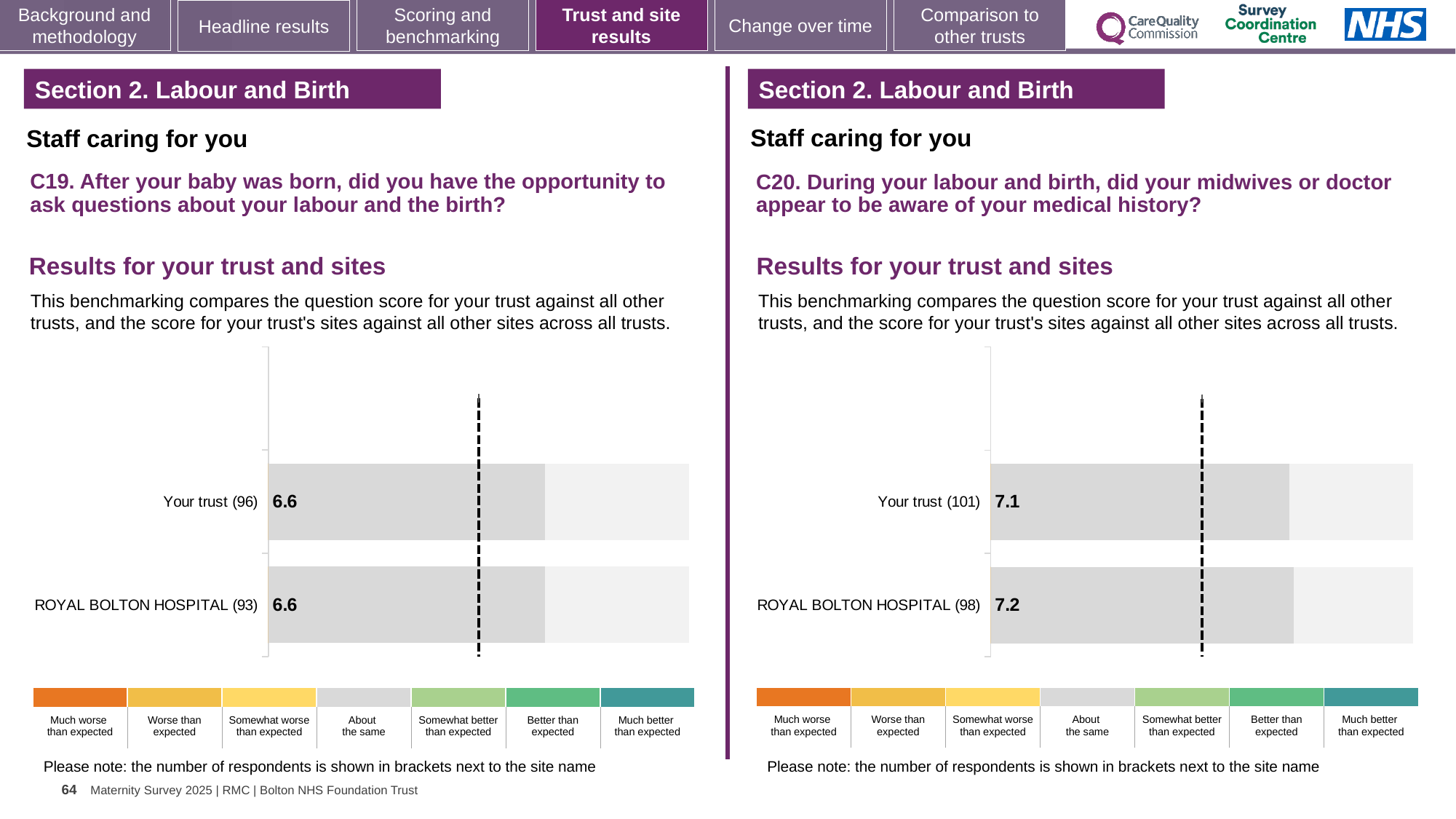
In the C19 chart on the left, what is the score for Your trust? 6.6 What type of chart is used for the C19 results on the left? Bar chart In the C19 chart on the left, what is the score for ROYAL BOLTON HOSPITAL? 6.6 In the C20 chart on the right, how many respondents are shown in brackets for ROYAL BOLTON HOSPITAL? 98 How many bars are plotted in the C19 chart on the left? 2 In the C19 chart on the left, what is the difference between the Your trust score and the ROYAL BOLTON HOSPITAL score? 0 In the C20 chart on the right, what is the score for ROYAL BOLTON HOSPITAL? 7.2 In the C20 chart on the right, what is the difference between the ROYAL BOLTON HOSPITAL score and the Your trust score? 0.1 How many bars are plotted in the C20 chart on the right? 2 In the C19 chart on the left, how many respondents are shown in brackets for Your trust? 96 In the C20 chart on the right, which has the higher score, Your trust or ROYAL BOLTON HOSPITAL? ROYAL BOLTON HOSPITAL In the C20 chart on the right, what is the score for Your trust? 7.1